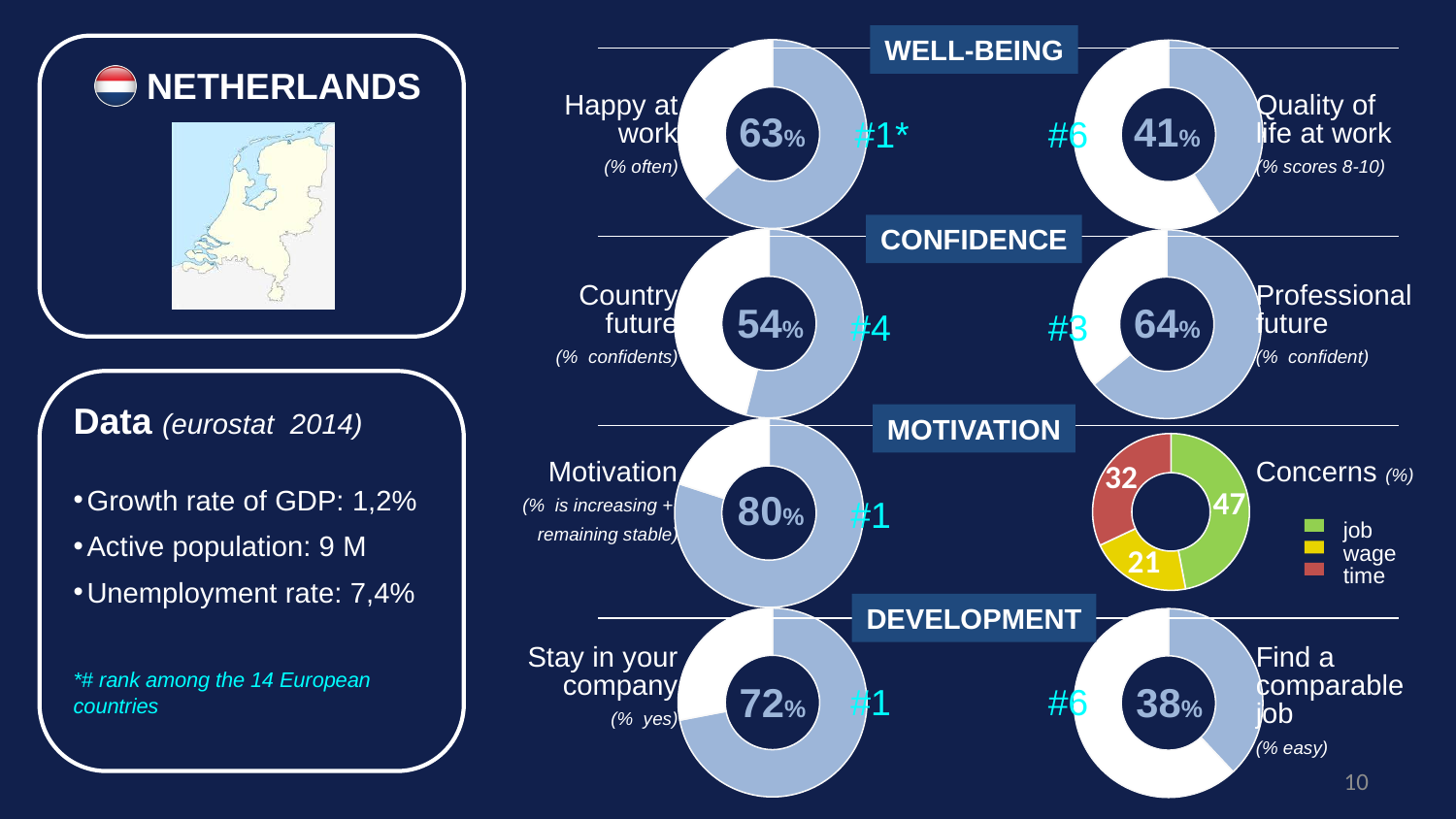
How many categories does the legend of the "Concerns" donut chart list? 3 In the "Professional future" donut chart, what percentage is shown? 64% In the "Happy at work" donut chart, what percentage is shown in the centre? 63% In the "Concerns" donut chart, what is the difference between the time slice and the wage slice? 11 In the "Quality of life at work" donut chart, what percentage is shown? 41% In the "Concerns" donut chart, what value is shown for the job slice? 47 In the "Country future" donut chart, what percentage is shown? 54% In the "Find a comparable job" donut chart, what percentage is shown? 38% In the "Concerns" donut chart, which category has the largest slice? job Which is larger: the percentage in the "Stay in your company" chart or the percentage in the "Find a comparable job" chart? Stay in your company In the "Motivation" donut chart, what percentage is shown? 80% In the "Concerns" donut chart, which category has the smallest slice? wage